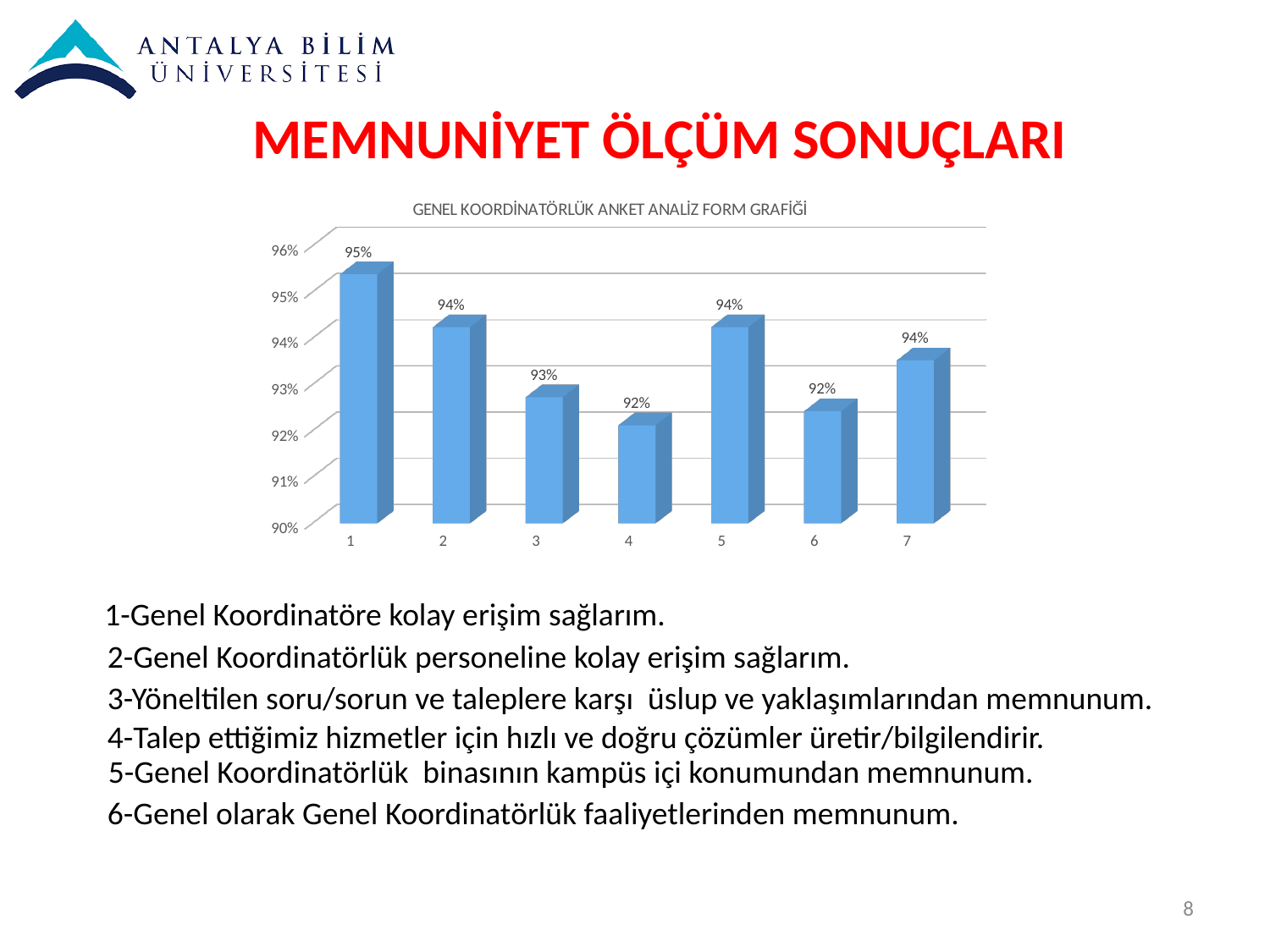
What is the difference between the values for category 1 and category 4? 3% What is the value for category 4? 92% Which is larger, the value for category 2 or the value for category 4? category 2 Is the value for category 1 greater or less than 94%? greater What is the title of the chart? GENEL KOORDİNATÖRLÜK ANKET ANALİZ FORM GRAFİĞİ What kind of chart is shown on the slide? bar chart What is the value for category 6? 92% How many categories are shown on the x axis? 7 What is the value for category 3? 93% Which category has the highest value? 1 What is the value for category 1? 95% What is the difference between the values for category 1 and category 3? 2%